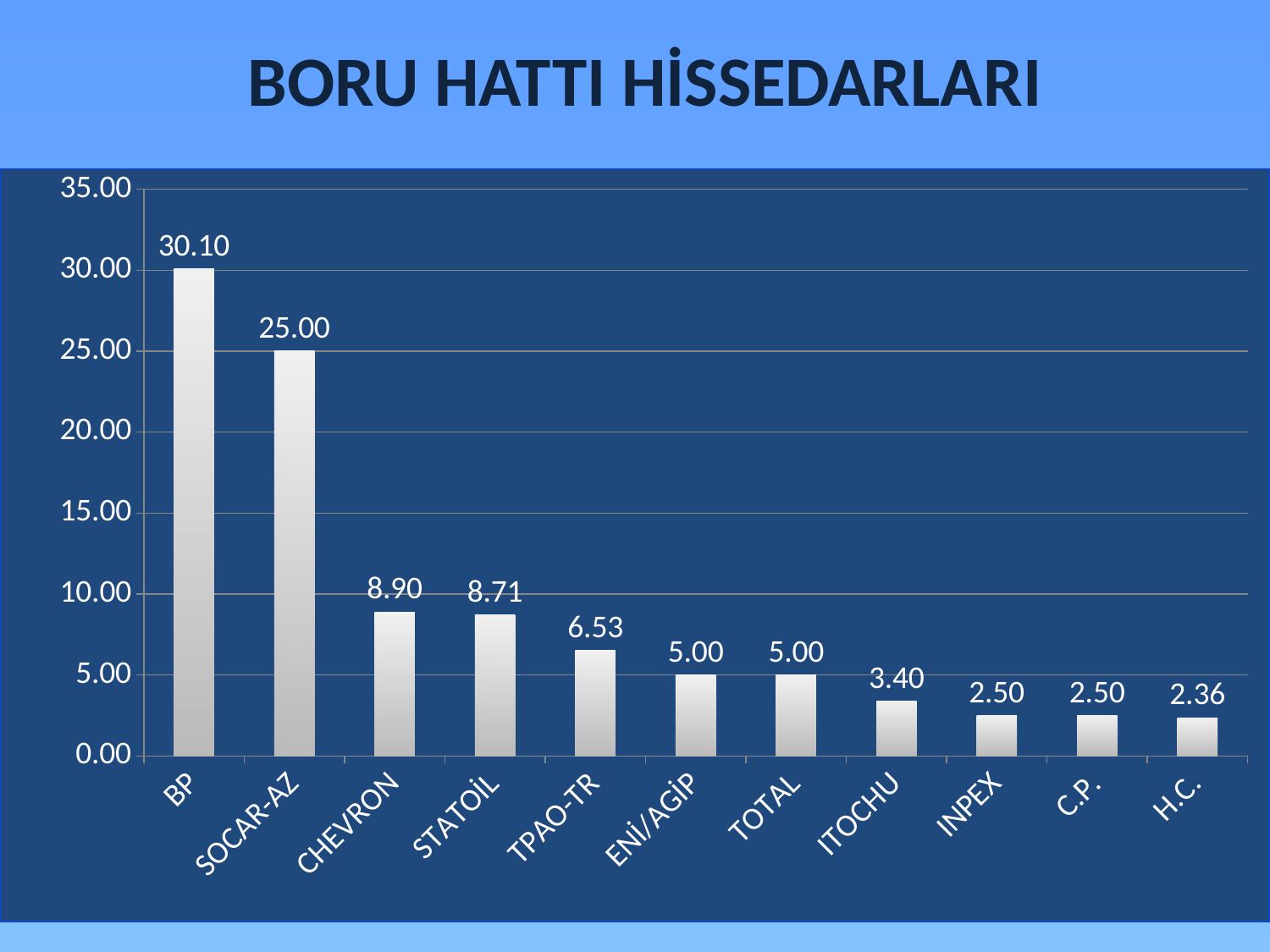
What is the value for BP? 30.10 What is the value for ITOCHU? 3.40 What is the value for TPAO-TR? 6.53 Which category has the highest value? BP Which is larger, the value for CHEVRON or the value for TPAO-TR? CHEVRON What kind of chart is shown on the slide? bar chart What is the value for SOCAR-AZ? 25.00 How many categories are shown on the x axis? 11 Is the value for STATOİL greater or less than 10.00? less Which category has the lowest value? H.C. What is the difference between the values for BP and SOCAR-AZ? 5.10 What is the title of the slide? BORU HATTI HİSSEDARLARI